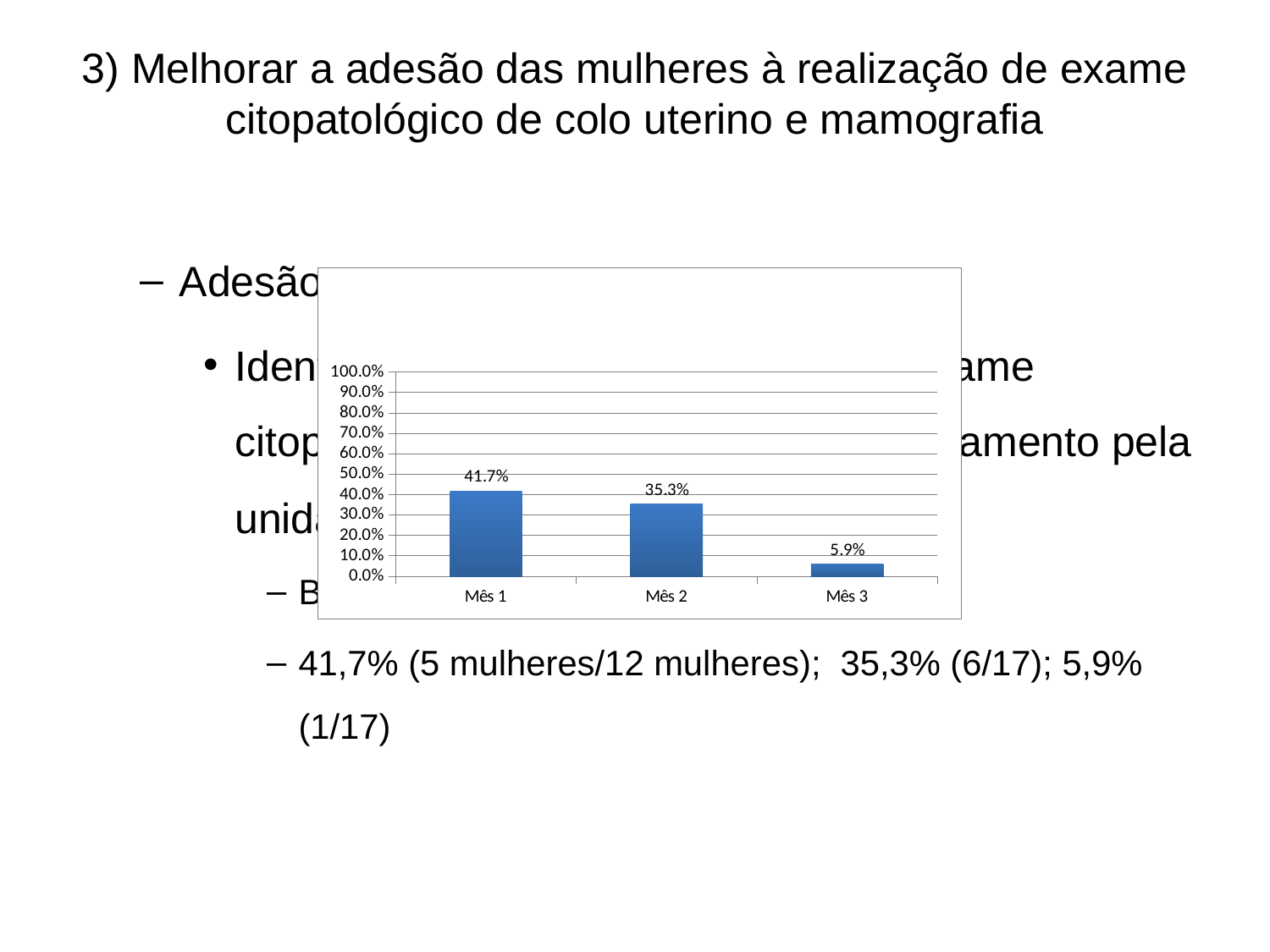
Which month has the highest value? Mês 1 Do the values rise or fall from Mês 1 to Mês 3? fall What is the difference between the values for Mês 1 and Mês 2? 6.4% How many categories are shown on the x axis? 3 Which month has the lowest value? Mês 3 What is the value for Mês 2? 35.3% What is the difference between the values for Mês 2 and Mês 3? 29.4% What is the value for Mês 1? 41.7% Is the value for Mês 1 greater or less than 40.0%? greater What kind of chart is shown on the slide? bar chart Which is larger, the value for Mês 2 or the value for Mês 3? Mês 2 What is the value for Mês 3? 5.9%